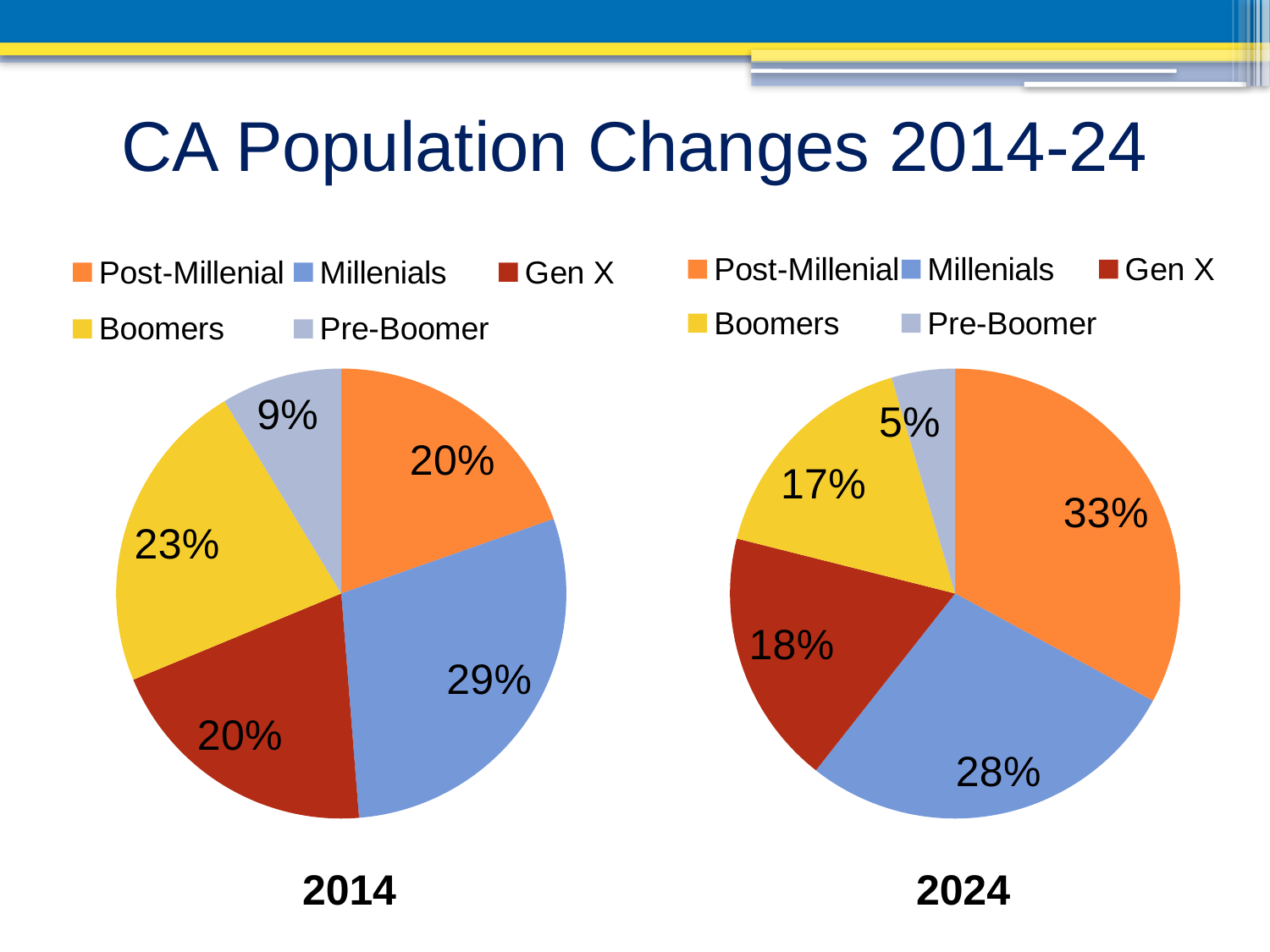
In the 2014 pie chart, what share is Pre-Boomer? 9% How many slices does the 2014 pie chart have? 5 In the 2024 pie chart, what share of the population is Post-Millenial? 33% In the 2014 pie chart, which group has the largest share? Millenials In the 2014 pie chart, what colour represents Boomers? Yellow What type of chart is used for the 2024 data? Pie chart What is the difference between the Post-Millenial share in the 2024 chart and the Post-Millenial share in the 2014 chart? 13 percentage points In the 2024 pie chart, which group has the smallest share? Pre-Boomer In the 2024 pie chart, which is larger: the Gen X share or the Boomers share? Gen X In the 2024 pie chart, which group has the largest share? Post-Millenial In the 2014 pie chart, what share of the population is Millenials? 29% In the 2024 pie chart, what share is Boomers? 17%